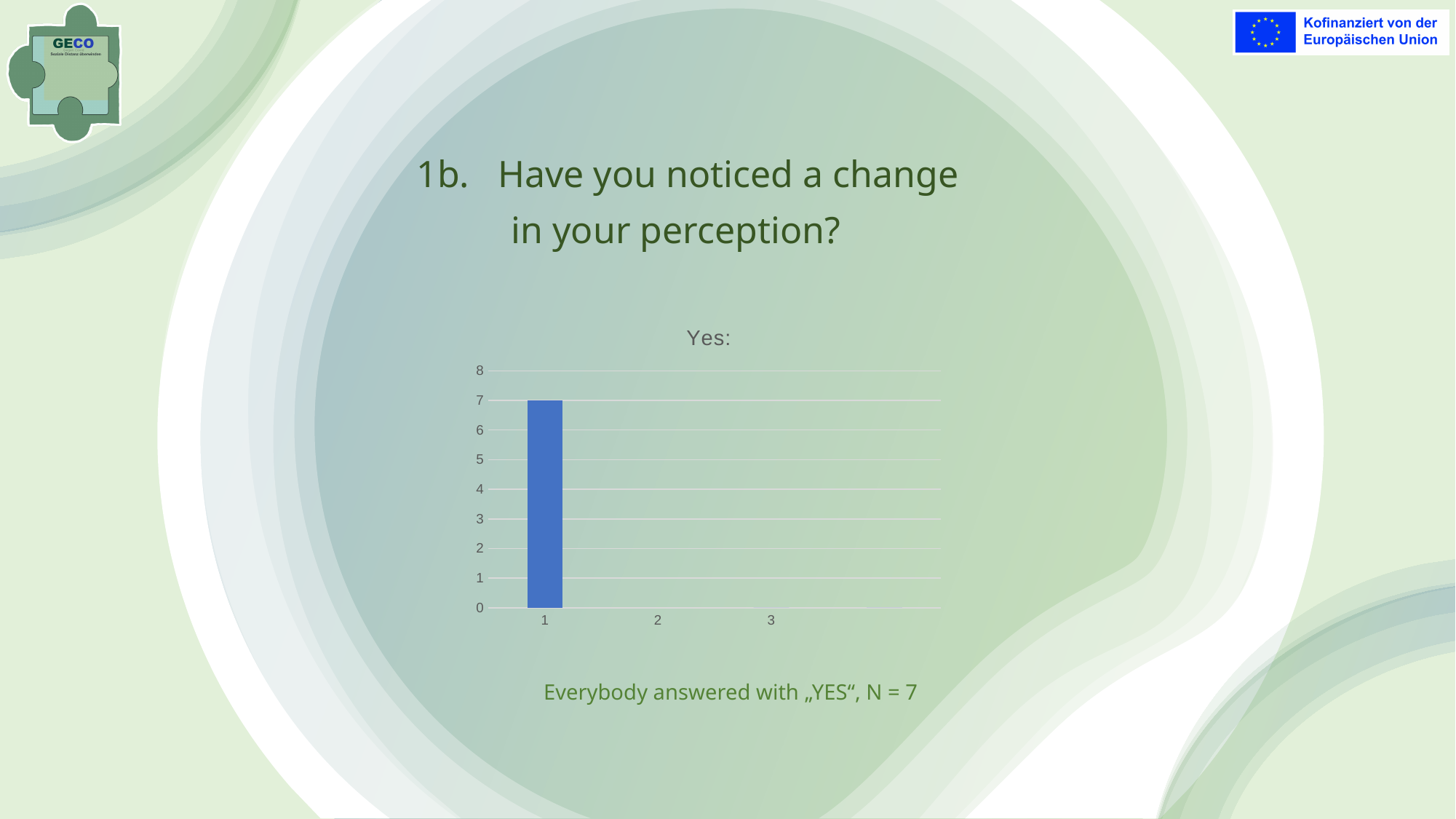
How many bars are visibly plotted in the chart? 1 What kind of chart is shown on the slide? bar chart Which category has the highest bar in the chart? 1 What is the highest value shown on the y axis of the chart? 8 Is the value for category 1 greater or less than 8? less Is the value for category 1 greater or less than 5? greater How many category labels are shown on the x axis of the chart? 3 What is the difference between the value for category 1 and the y-axis maximum of 8? 1 What is the value of the bar for category 1 in the "Yes:" chart? 7 What is the title of the chart? Yes: